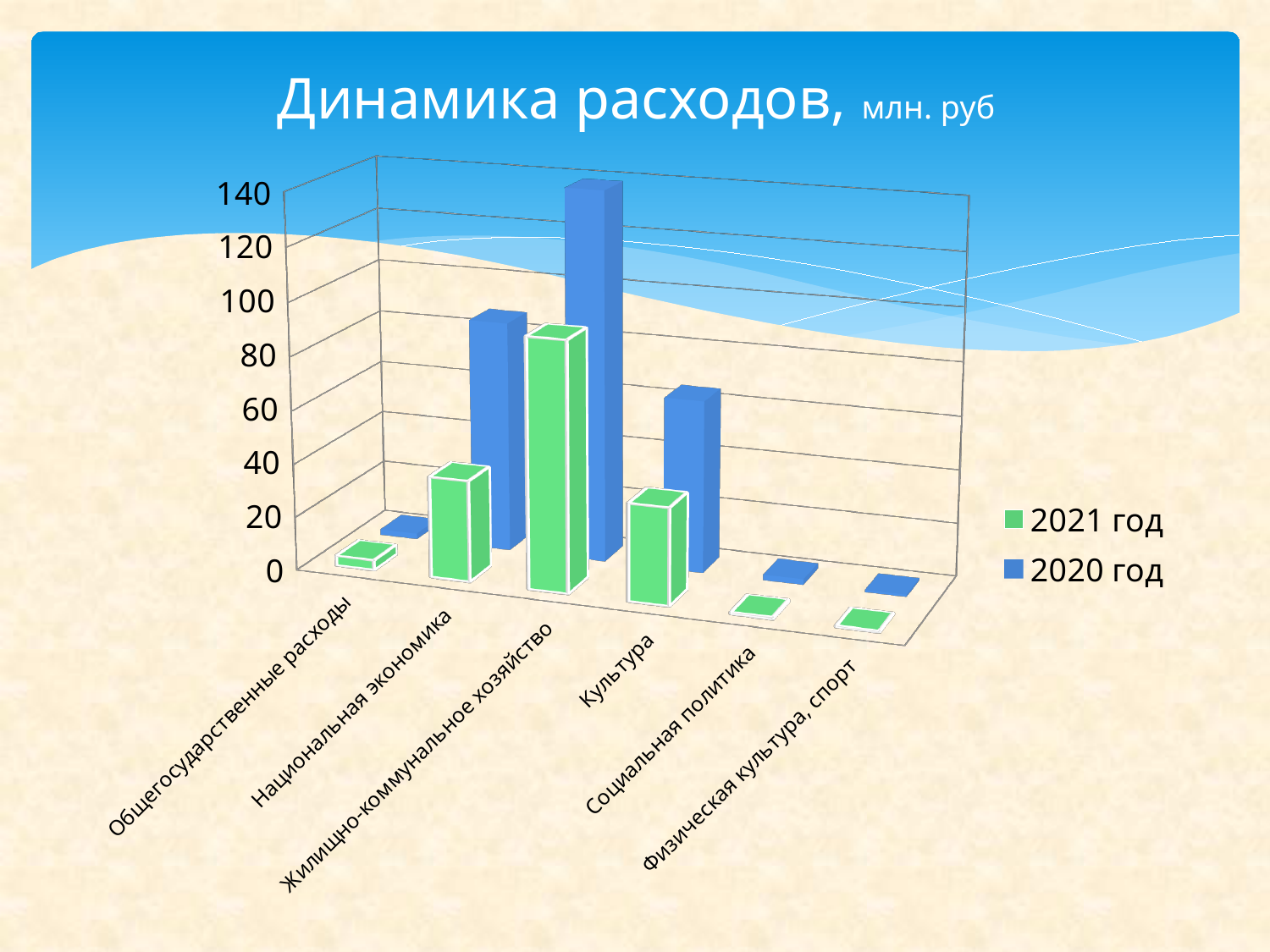
How many expense categories are shown on the x axis? 6 What kind of chart is shown on the slide? bar chart Which category has the highest value for 2020 год? Жилищно-коммунальное хозяйство Is the 2021 год value for Общегосударственные расходы greater or less than 20? less Is the 2021 год value for Национальная экономика greater or less than 60? less Which category has the highest value for 2021 год? Жилищно-коммунальное хозяйство How many series does the legend list? 2 Which colour represents the 2021 год series in the legend? green Is the 2020 год value for Жилищно-коммунальное хозяйство greater or less than 100? greater For Национальная экономика, which year has the larger value, 2020 год or 2021 год? 2020 год For Культура, which year has the larger value, 2020 год or 2021 год? 2020 год